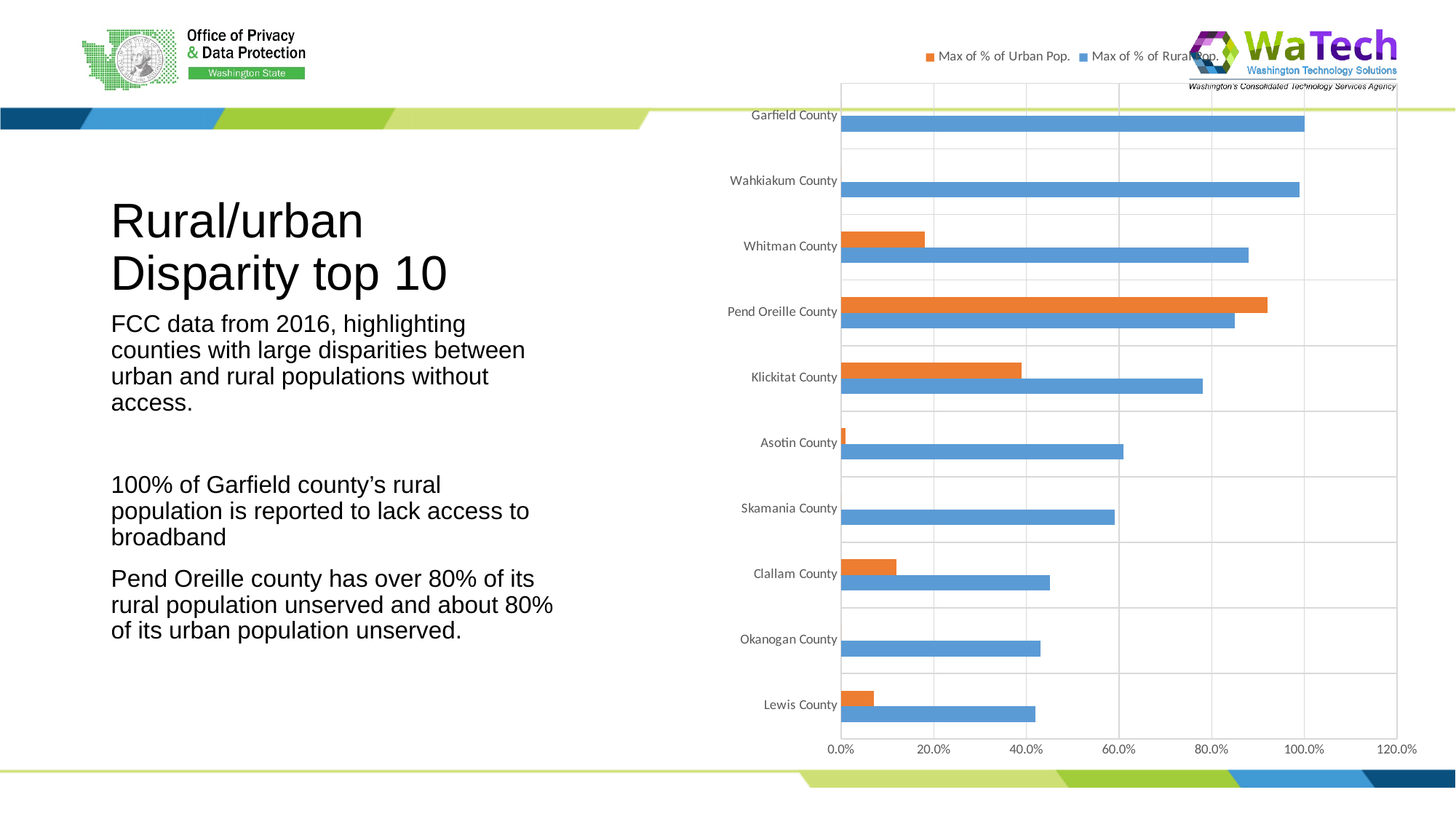
Is the Max of % of Rural Pop. value for Clallam County greater or less than 40.0%? greater Which county has the highest value for Max of % of Urban Pop.? Pend Oreille County Is the Max of % of Urban Pop. value for Whitman County greater or less than 20.0%? less For Klickitat County, which is larger: Max of % of Urban Pop. or Max of % of Rural Pop.? Max of % of Rural Pop. What is the Max of % of Rural Pop. value for Garfield County? 100.0% Which colour represents the Max of % of Rural Pop. series? blue Is the Max of % of Urban Pop. value for Pend Oreille County greater or less than 80.0%? greater How many series does the chart legend list? 2 How many counties are listed on the chart? 10 What kind of chart is shown on the slide? bar chart Which county has the highest value for Max of % of Rural Pop.? Garfield County